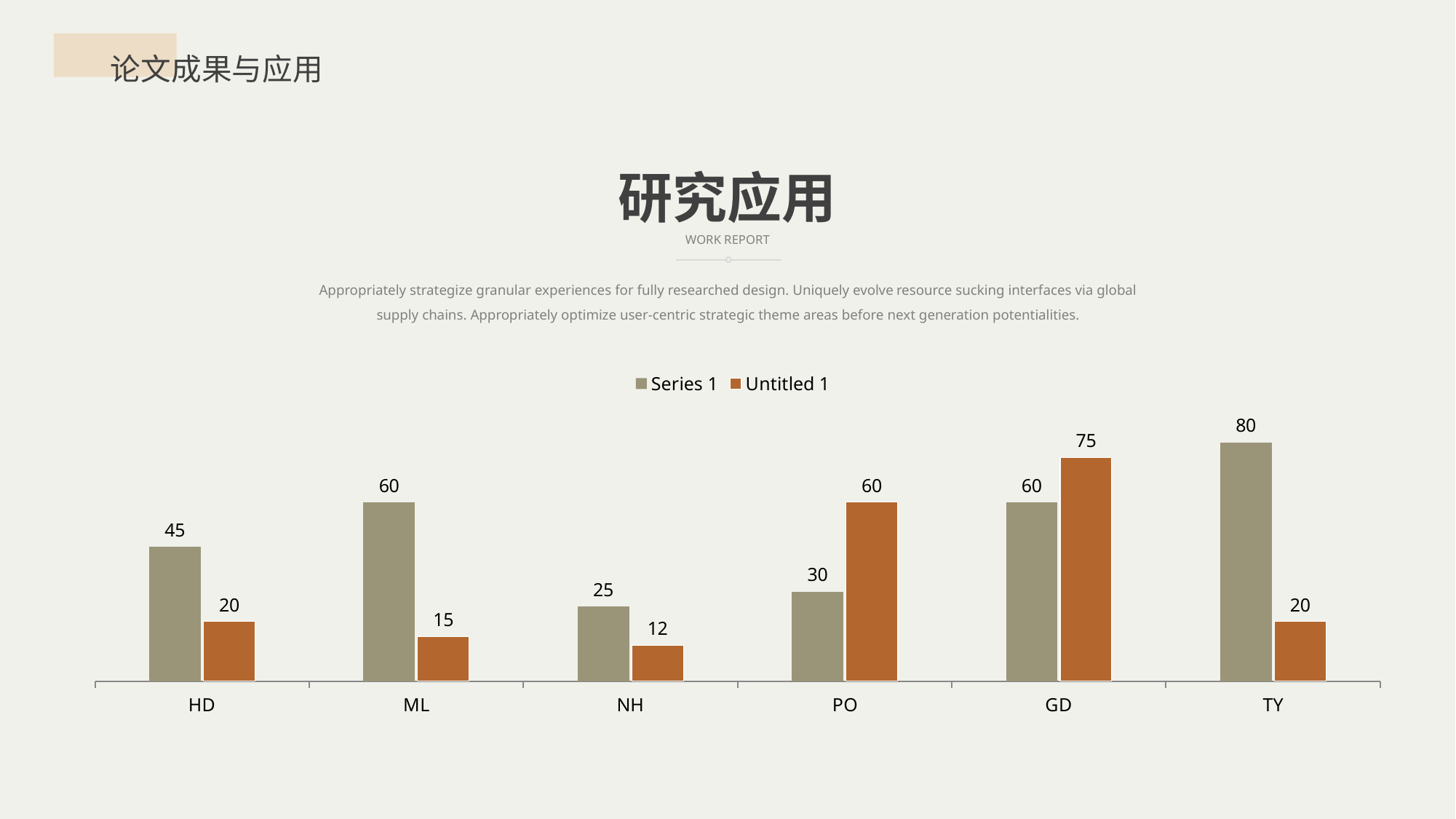
How many categories are shown on the x axis? 6 Which category has the highest Series 1 value? TY Which category has the lowest Untitled 1 value? NH How many series does the legend list? 2 What are the two series names listed in the legend? Series 1 and Untitled 1 What is the value of Series 1 for HD? 45 What is the difference between the Series 1 and Untitled 1 values for ML? 45 What kind of chart is shown on the slide? Bar chart What is the value of Untitled 1 for NH? 12 What is the difference between the Series 1 values for TY and HD? 35 For PO, which series has the larger value, Series 1 or Untitled 1? Untitled 1 What is the value of Untitled 1 for GD? 75